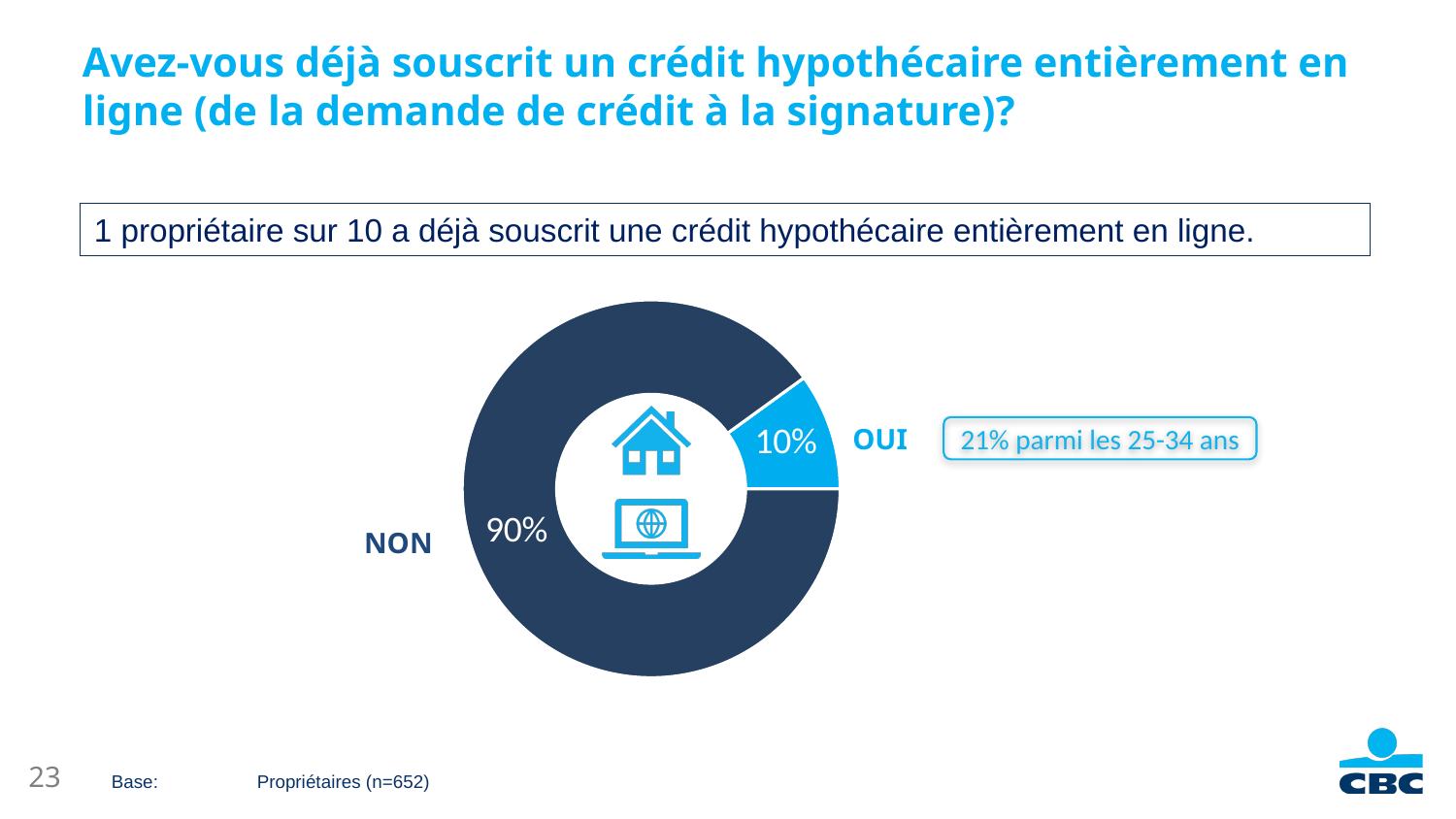
What share of the pie does the OUI slice represent? 10% Which category has the smallest share of the chart? OUI Which is larger, the share for OUI or the share for NON? NON What kind of chart is shown on the slide? Pie chart (donut) What is the difference in percentage points between NON and OUI? 80 Which category has the largest share of the chart? NON What percentage of respondents answered OUI? 10% What is the base (sample size) stated for the chart? Propriétaires (n=652) What percentage of respondents answered NON? 90% How many categories are shown in the chart? 2 According to the callout next to the chart, what percentage of 25-34 year olds answered OUI? 21%